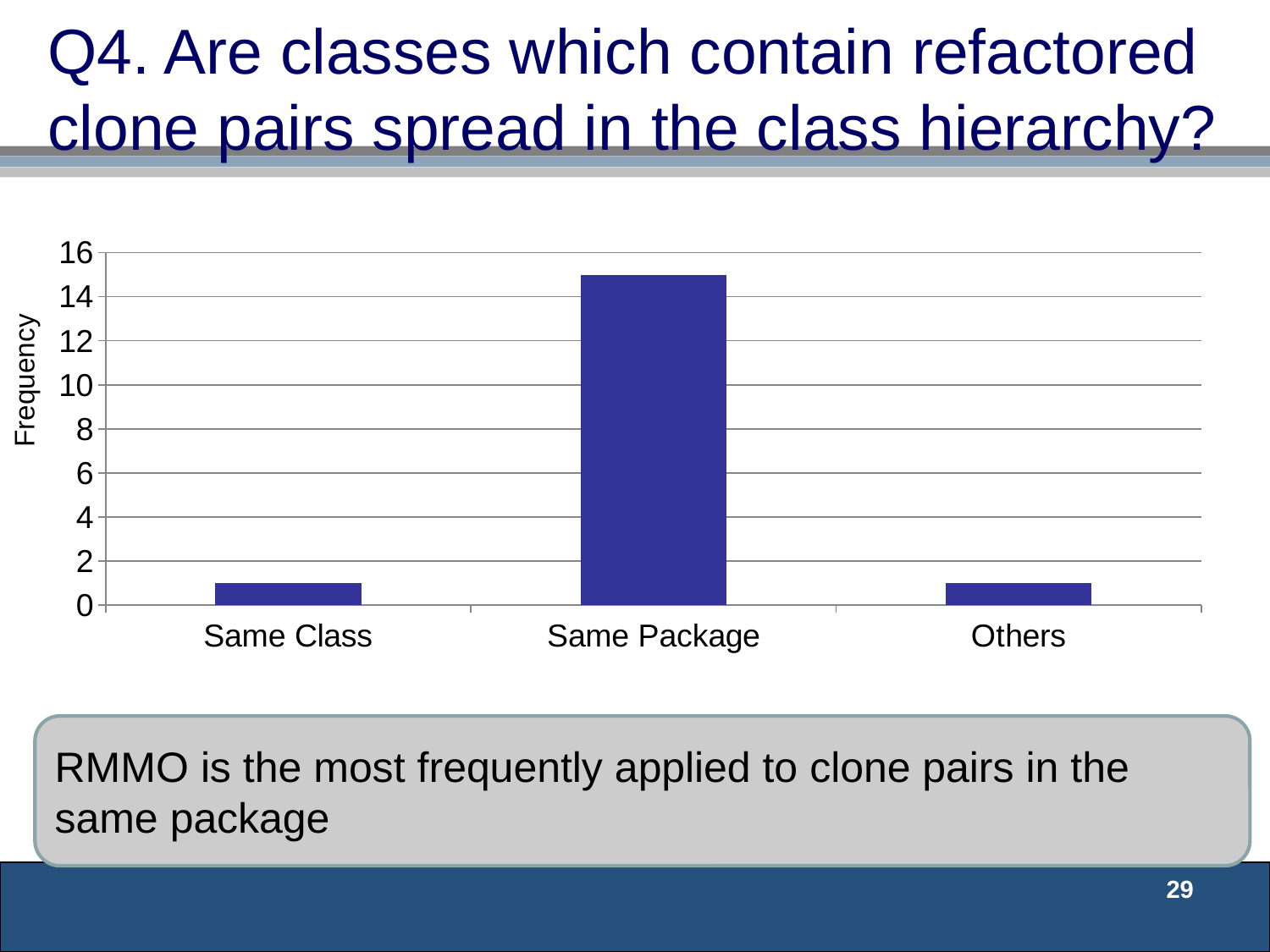
Which category has the highest frequency? Same Package Which has a higher frequency, Others or Same Package? Same Package Is the value for Same Package greater or less than 14? greater Which has a higher frequency, Same Package or Same Class? Same Package What is the label of the y axis? Frequency What kind of chart is shown on the slide? bar chart What is the highest tick value shown on the y axis? 16 Is the value for Same Package greater or less than 16? less Is the value for Same Package greater or less than 10? greater How many categories are shown on the x axis of the chart? 3